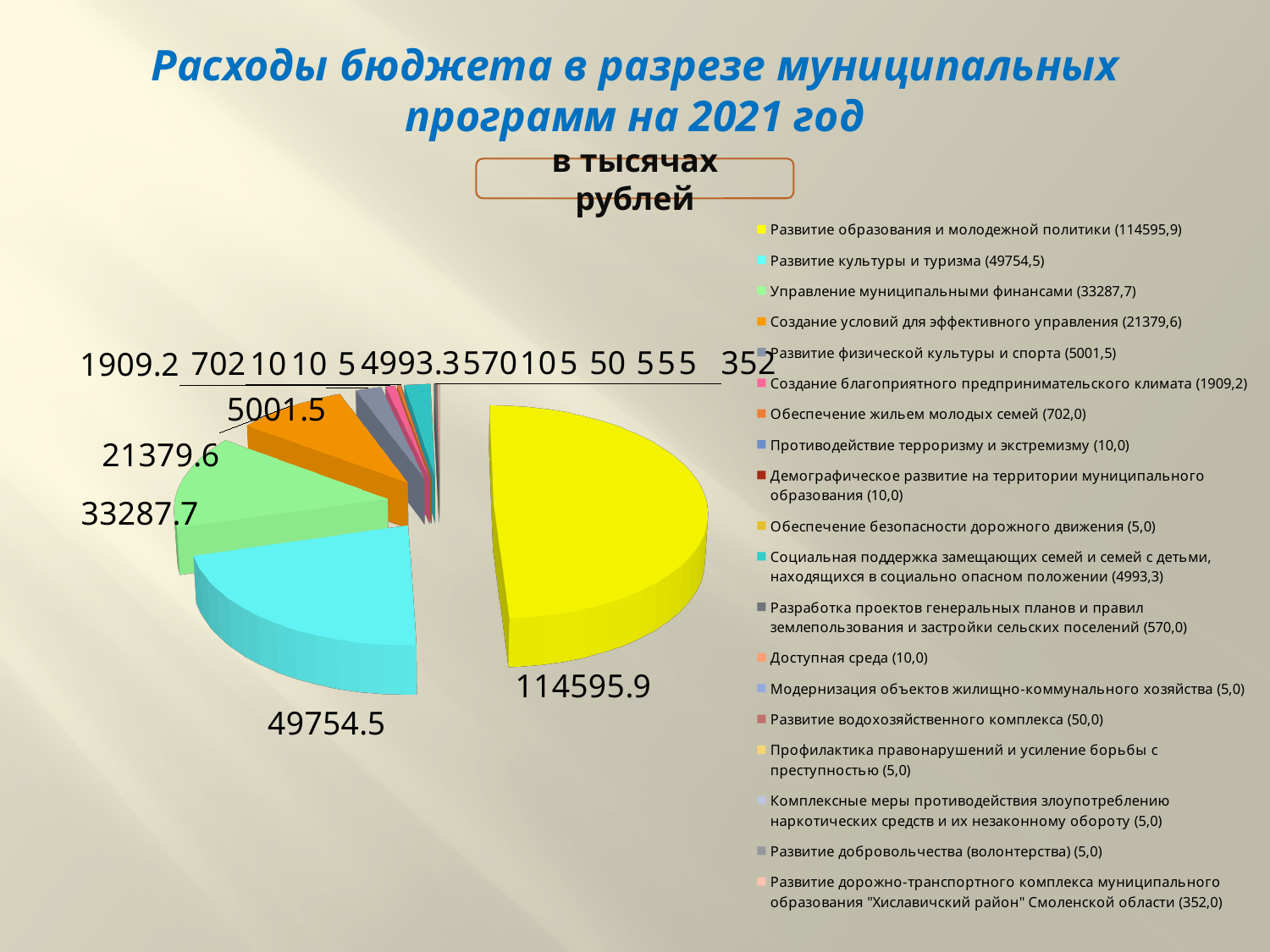
What kind of chart is shown on the slide? pie chart What unit is stated in the box below the title? в тысячах рублей What is the value for Развитие культуры и туризма? 49754.5 Which category has the largest slice of the pie? Развитие образования и молодежной политики What is the value for Управление муниципальными финансами? 33287.7 How many categories does the legend list? 19 What is the value for Развитие физической культуры и спорта? 5001.5 What is the value for Развитие водохозяйственного комплекса according to the legend? 50,0 What colour is the slice for Развитие образования и молодежной политики? yellow What is the value for Развитие образования и молодежной политики? 114595.9 What is the difference between the values for Развитие образования и молодежной политики and Развитие культуры и туризма? 64841.4 Which is larger: the value for Управление муниципальными финансами or the value for Создание условий для эффективного управления? Управление муниципальными финансами